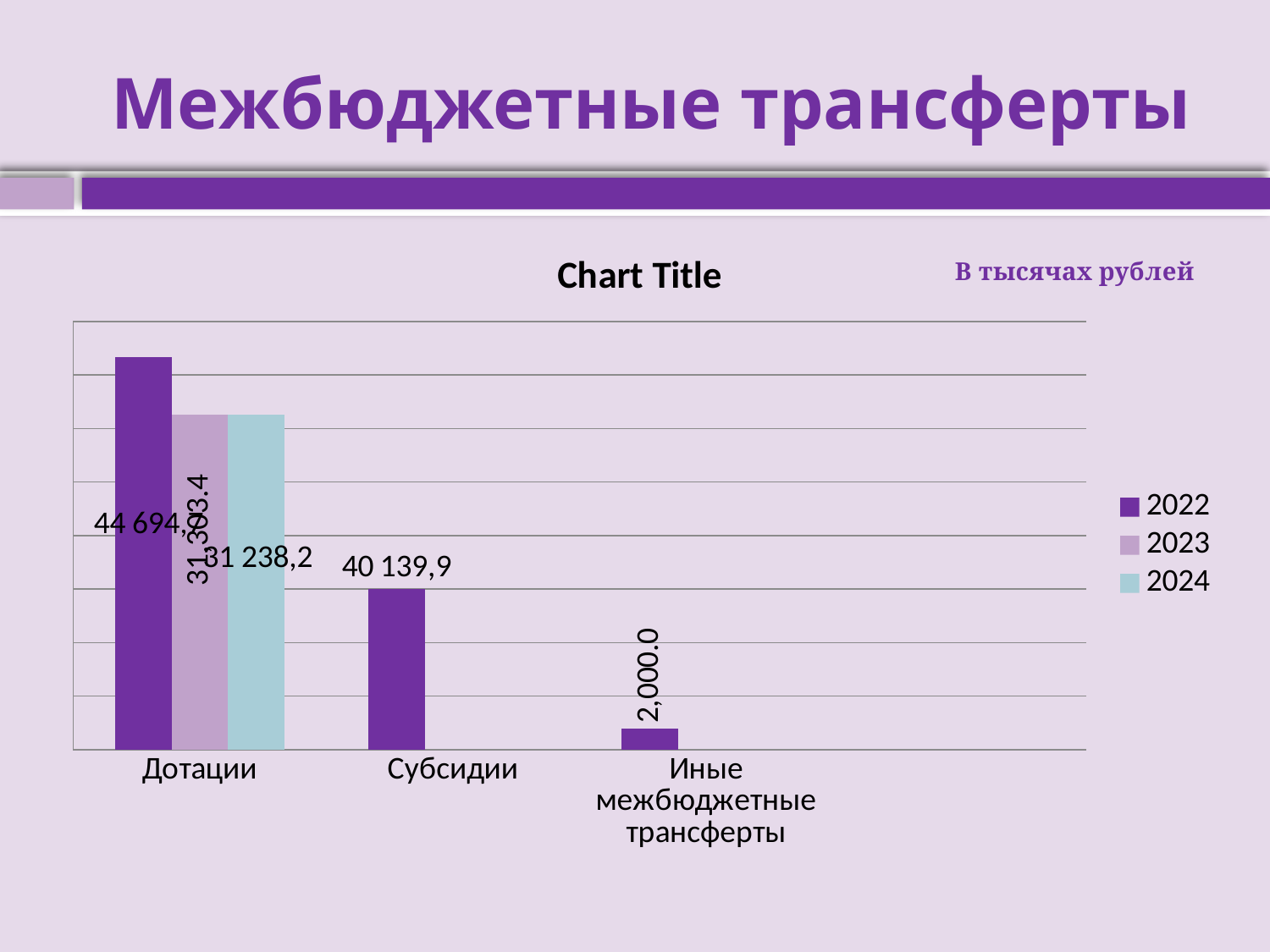
Which years are listed in the legend? 2022, 2023, 2024 What is the value for Субсидии in 2022? 40 139,9 What kind of chart is shown on the slide? bar chart How many categories are shown on the x axis? 3 Which category has the highest 2022 value? Дотации What is the value for Дотации in 2024? 31 238,2 How many series does the legend list? 3 Which category has the lowest 2022 value? Иные межбюджетные трансферты What is the difference between Субсидии in 2022 and Дотации in 2024? 8 901,7 What is the value for Иные межбюджетные трансферты in 2022? 2,000.0 In what units are the values given, according to the note next to the chart? В тысячах рублей